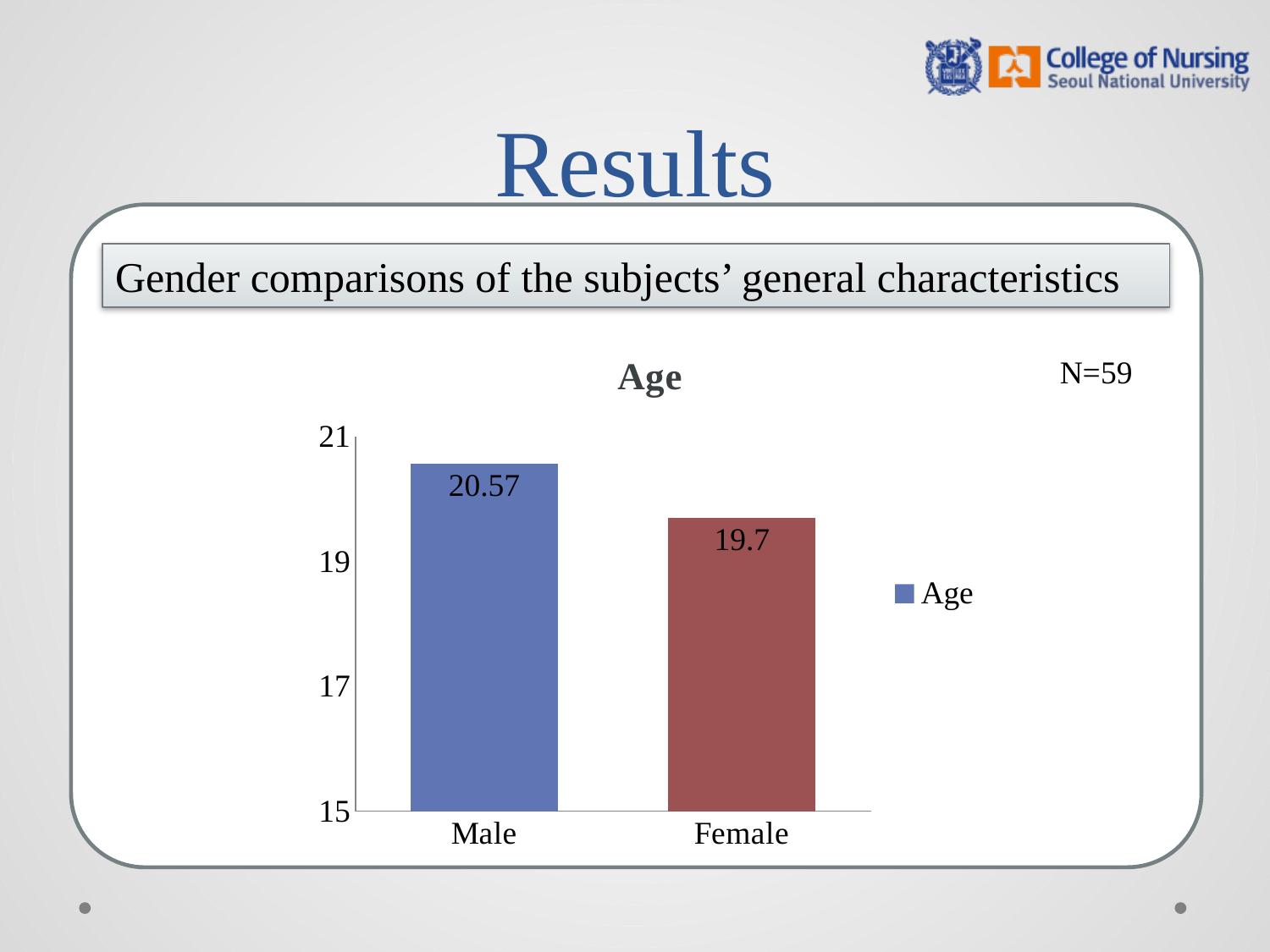
Is the value for Male in the Age chart greater or less than 21? less What is the value for Female in the Age chart? 19.7 Which category has the highest value in the Age chart? Male Which category has the lowest value in the Age chart? Female Is the value for Female in the Age chart greater or less than 19? greater How many categories are shown in the Age chart? 2 What is the value for Male in the Age chart? 20.57 What kind of chart is the Age chart? bar chart How many series does the legend of the Age chart list? 1 What is the title of the chart on the slide? Age Which is larger in the Age chart, the value for Male or the value for Female? Male What is the difference between the Male and Female values in the Age chart? 0.87